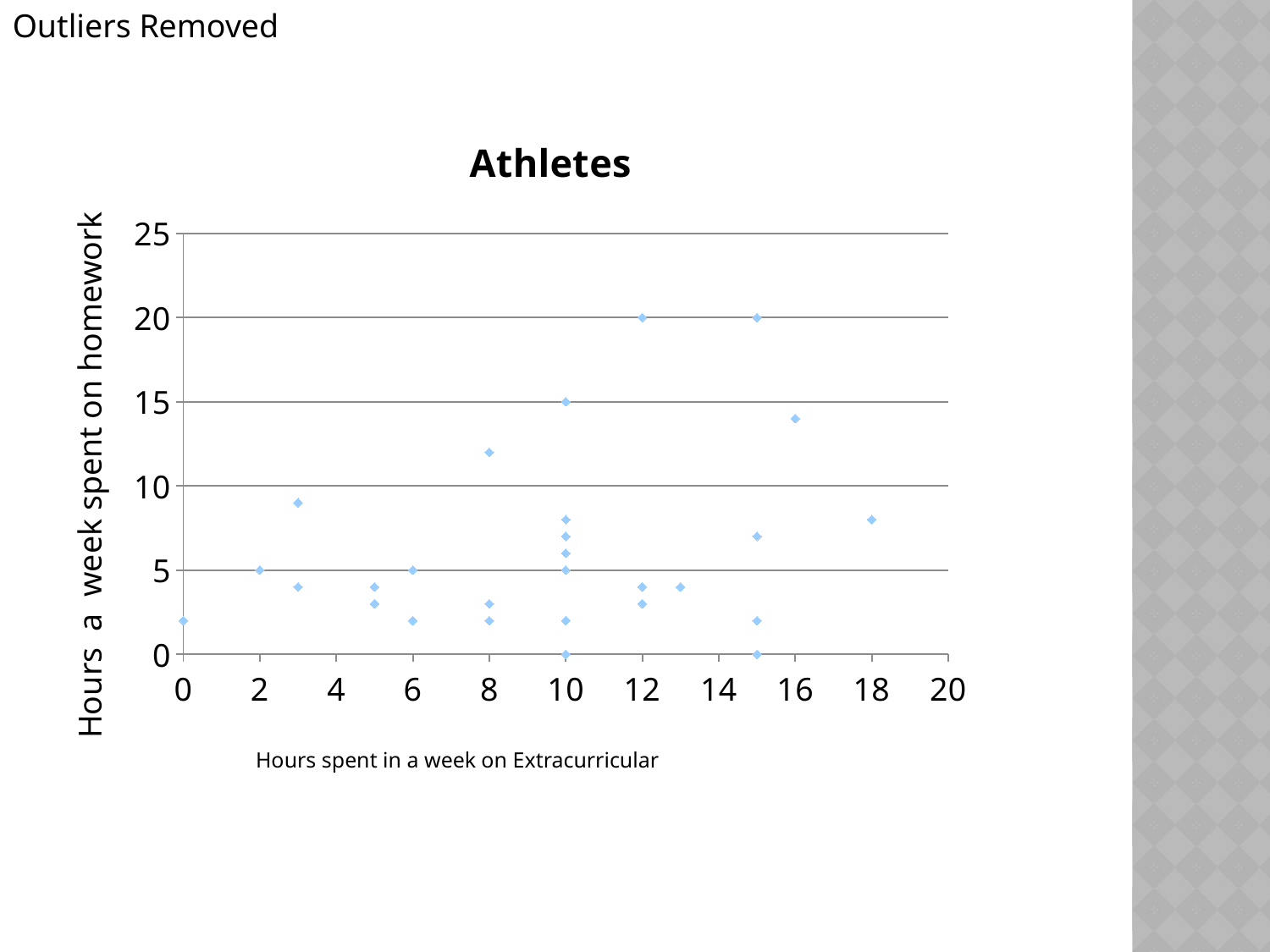
What is the label of the horizontal axis? Hours spent in a week on Extracurricular What is the highest value shown on the vertical axis? 25 Is the homework-hours value for the point at 18 extracurricular hours greater or less than 10? less Is the homework-hours value for the point at 0 extracurricular hours greater or less than 5? less Which has the higher homework-hours value: the point at 16 extracurricular hours or the point at 18 extracurricular hours? the point at 16 What is the highest value shown on the horizontal axis? 20 Is the homework-hours value for the point at 16 extracurricular hours greater or less than 10? greater What is the title of the chart? Athletes How many points are plotted at 10 extracurricular hours? 7 What kind of chart is shown on the slide? scatter plot What is the lowest homework-hours value plotted on the chart? 0 What is the highest homework-hours value plotted on the chart? 20